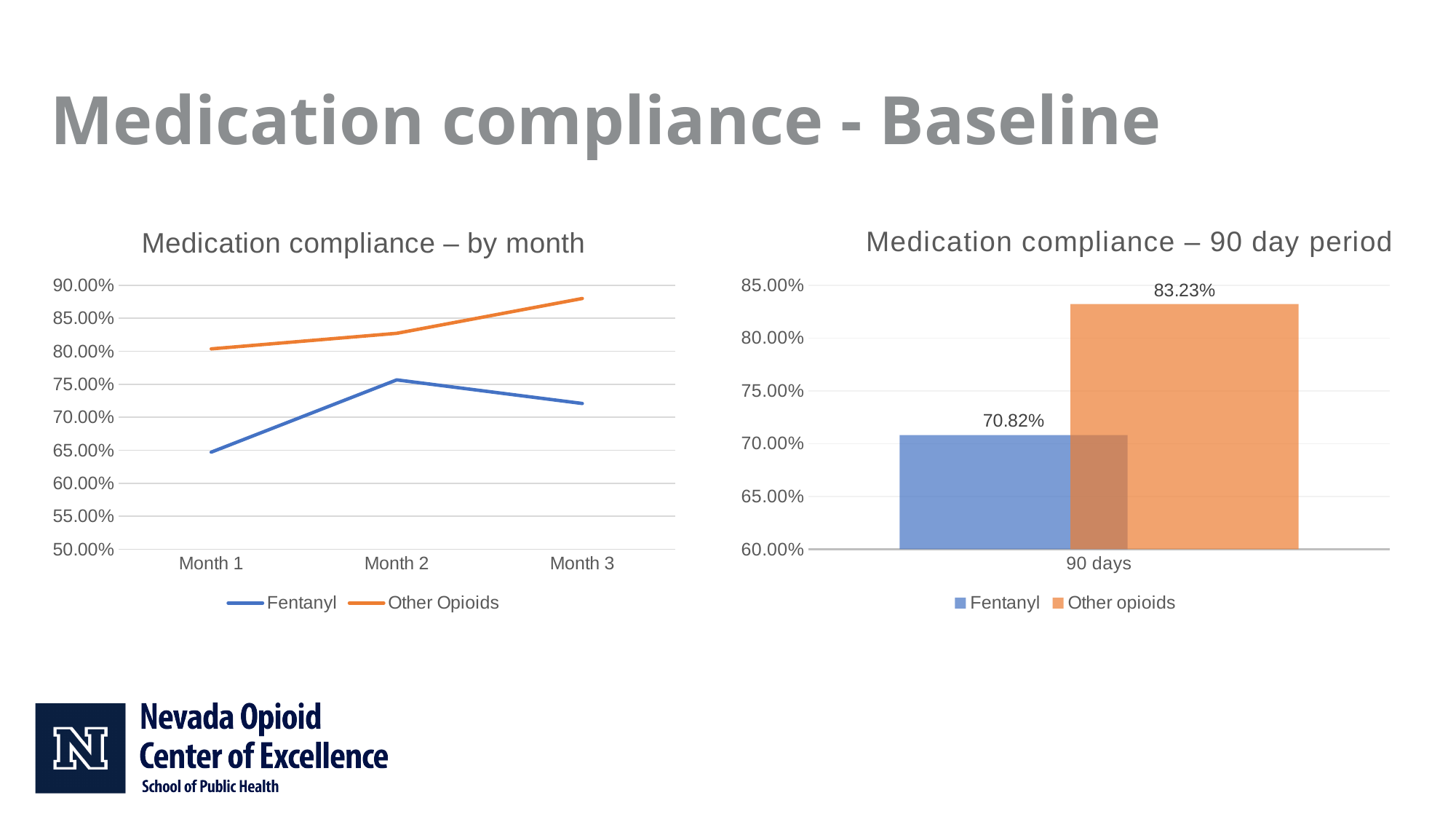
What kind of chart is the 'Medication compliance – 90 day period' chart? Bar chart In the 'Medication compliance – 90 day period' chart, what is the value for Other opioids? 83.23% How many series does the legend of the 'Medication compliance – by month' chart list? 2 In the 'Medication compliance – 90 day period' chart, what is the difference between the Other opioids value and the Fentanyl value? 12.41% In the 'Medication compliance – 90 day period' chart, which is larger, Fentanyl or Other opioids? Other opioids In the 'Medication compliance – by month' chart, is the Fentanyl value for Month 3 greater or less than 70.00%? greater What kind of chart is the 'Medication compliance – by month' chart? Line chart In the 'Medication compliance – by month' chart, is the Other Opioids value for Month 3 greater or less than 85.00%? greater In the 'Medication compliance – by month' chart, does the Fentanyl value rise or fall from Month 2 to Month 3? Fall In the 'Medication compliance – by month' chart, do the Other Opioids values rise or fall from Month 1 to Month 3? Rise How many months are shown on the x axis of the 'Medication compliance – by month' chart? 3 In the 'Medication compliance – 90 day period' chart, what is the value for Fentanyl? 70.82%